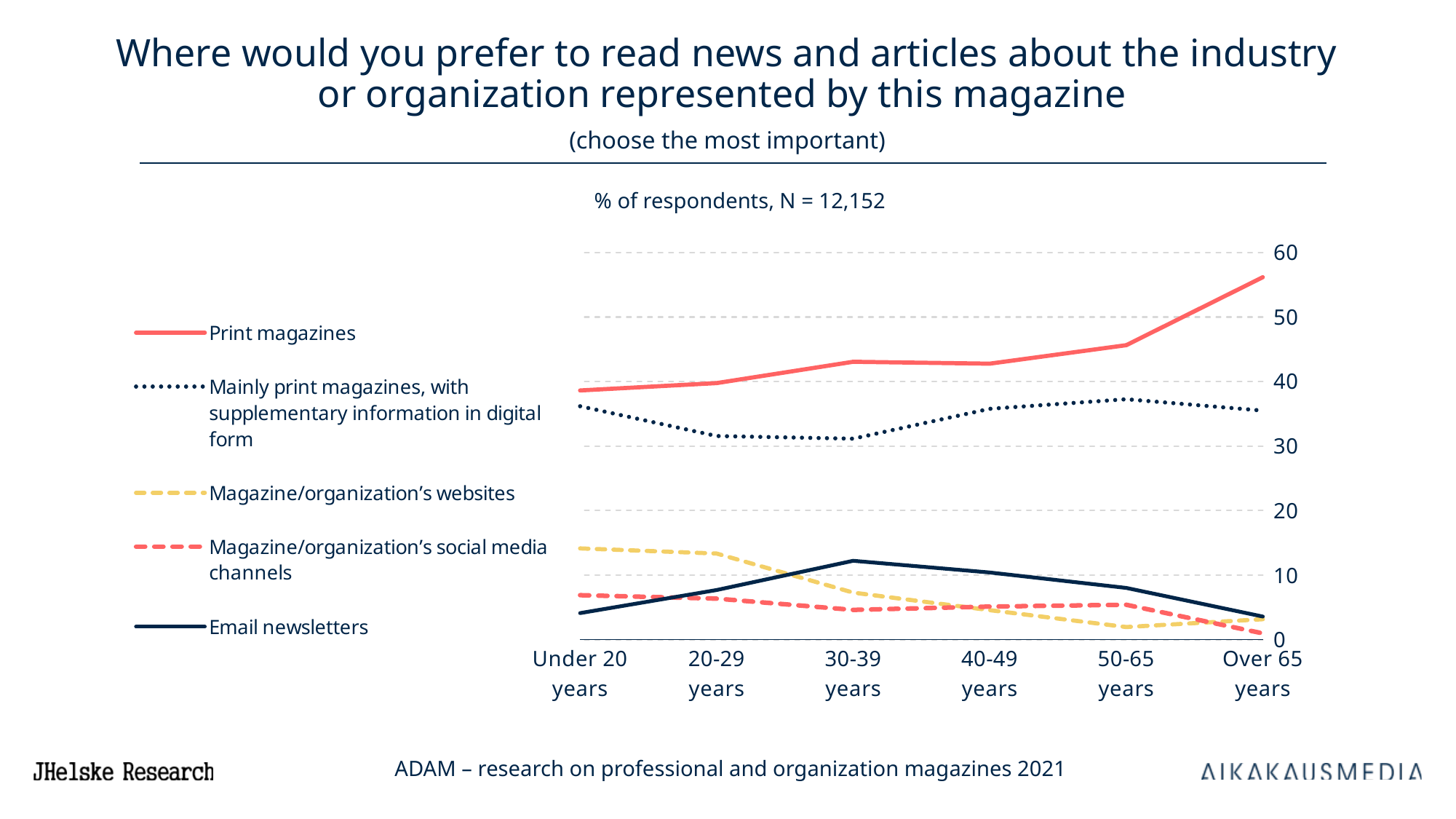
In the Under 20 years group, which is higher: Print magazines or Mainly print magazines, with supplementary information in digital form? Print magazines How many series does the legend list? 5 Is the value for Mainly print magazines, with supplementary information in digital form in the 30-39 years group greater or less than 40? less Which age group has the lowest value for Print magazines? Under 20 years What is the number of respondents (N) stated above the chart? 12,152 Do the values for Print magazines rise or fall as age increases along the x axis? rise How many age groups are shown on the x axis? 6 Is the value for Print magazines in the Over 65 years group greater or less than 50? greater Which age group has the highest value for Print magazines? Over 65 years Which age group has the highest value for Email newsletters? 30-39 years What kind of chart is shown on the slide? line chart Is the value for Email newsletters in the Under 20 years group greater or less than 10? less